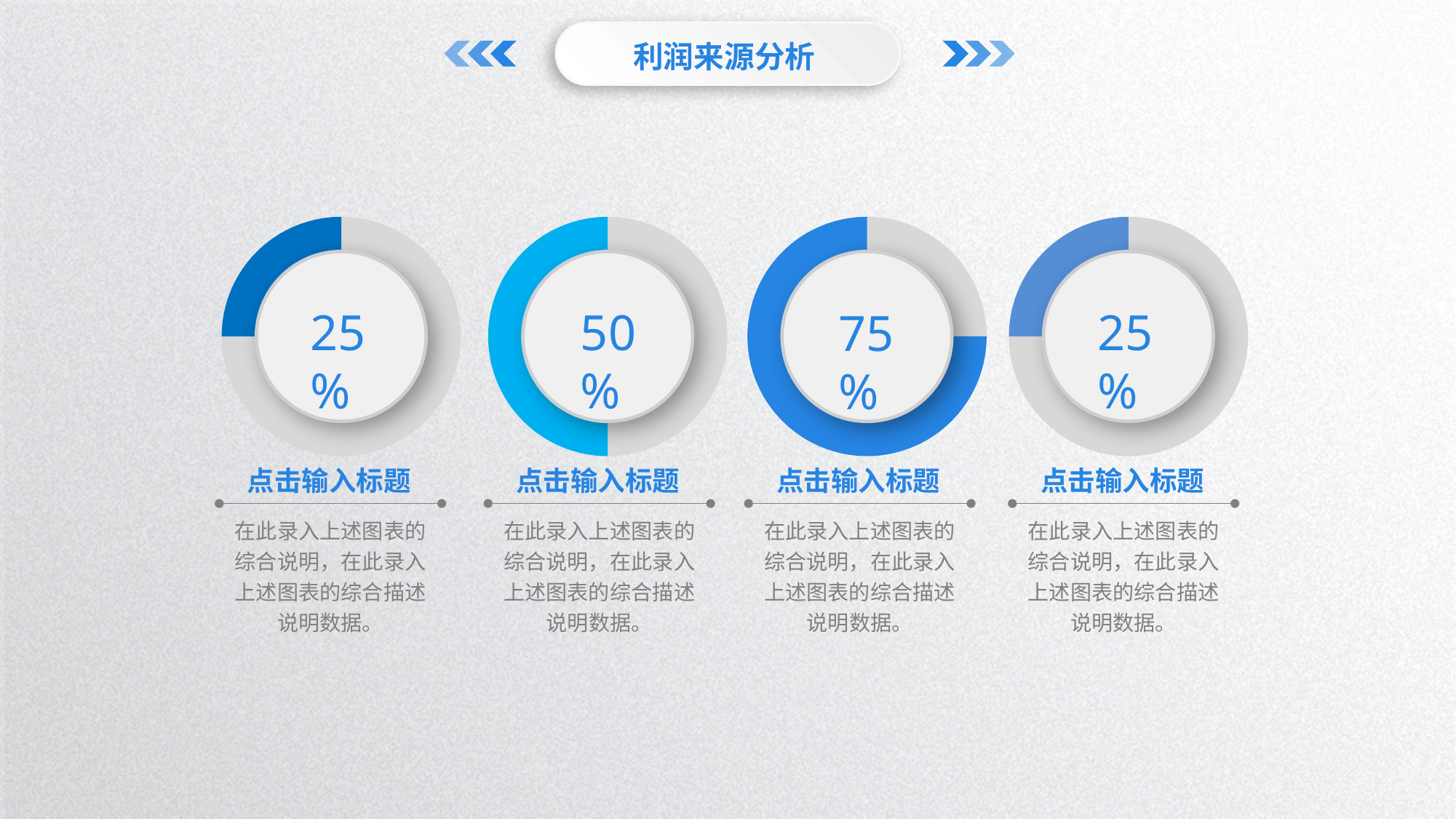
What kind of chart is used to display the percentages on this slide? Ring (donut) chart What value is shown in the second ring chart from the left? 50% What is the difference between the value in the third ring chart and the value in the second ring chart? 25% How many of the ring charts show a value of 25%? 2 What is the title of the slide containing the ring charts? 利润来源分析 Which is larger, the value in the second ring chart or the value in the first ring chart? The second ring chart (50%) What value is shown in the fourth (rightmost) ring chart? 25% Which ring chart shows the highest value? The third from the left (75%) What is the difference between the value in the third ring chart and the value in the fourth ring chart? 50% How many ring charts are shown on the slide? 4 What value is shown in the third ring chart from the left? 75% What value is shown in the first (leftmost) ring chart? 25%